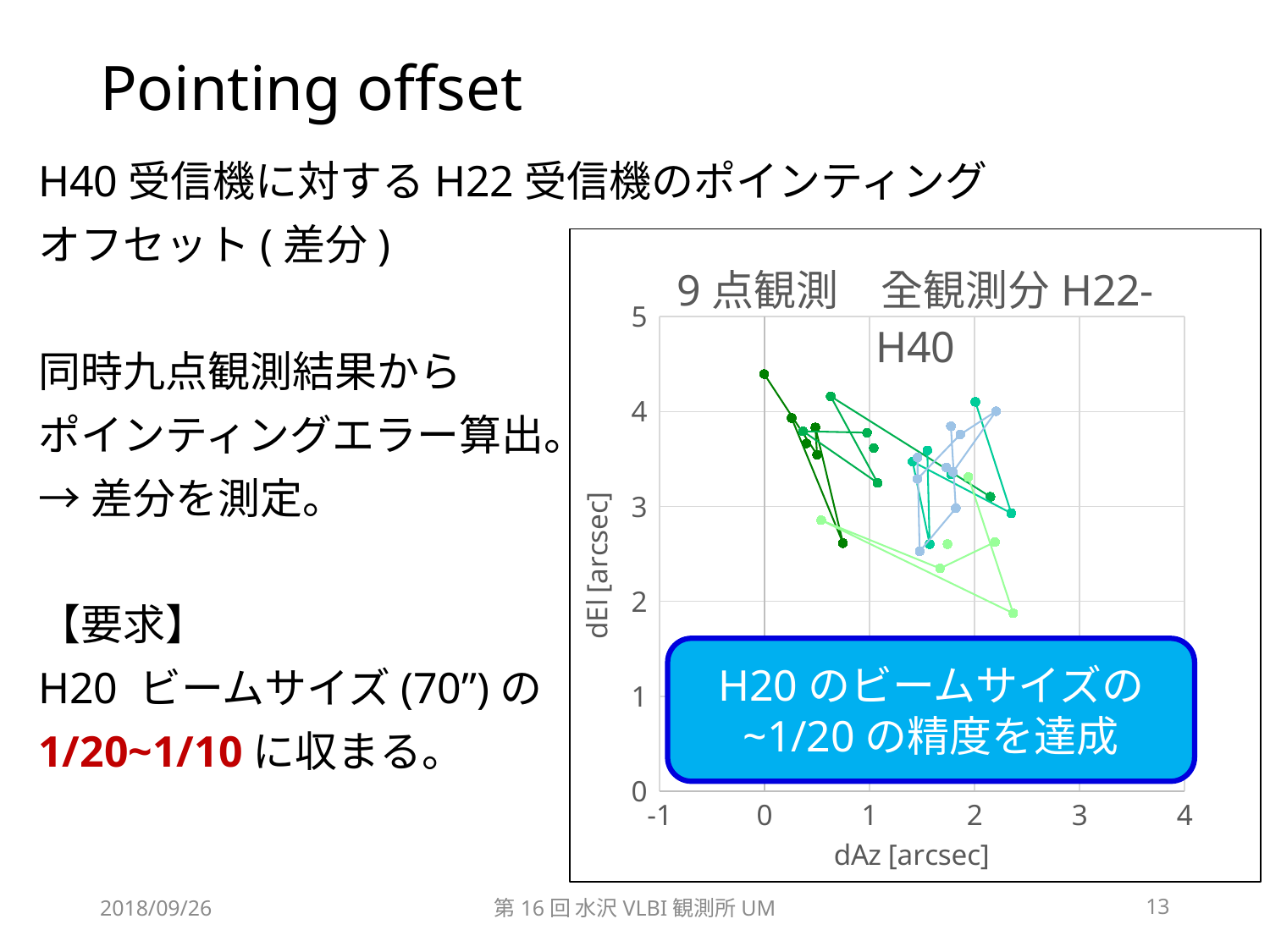
Is the smallest dAz value plotted on the chart greater or less than -1? greater Is the largest dAz value plotted on the chart greater or less than 3? less What kind of chart is shown on the slide? scatter chart Is the highest dEl value plotted on the chart greater or less than 4? greater What is the title of the chart on the slide? 9点観測 全観測分 H22-H40 What is the label of the horizontal axis of the chart? dAz [arcsec]